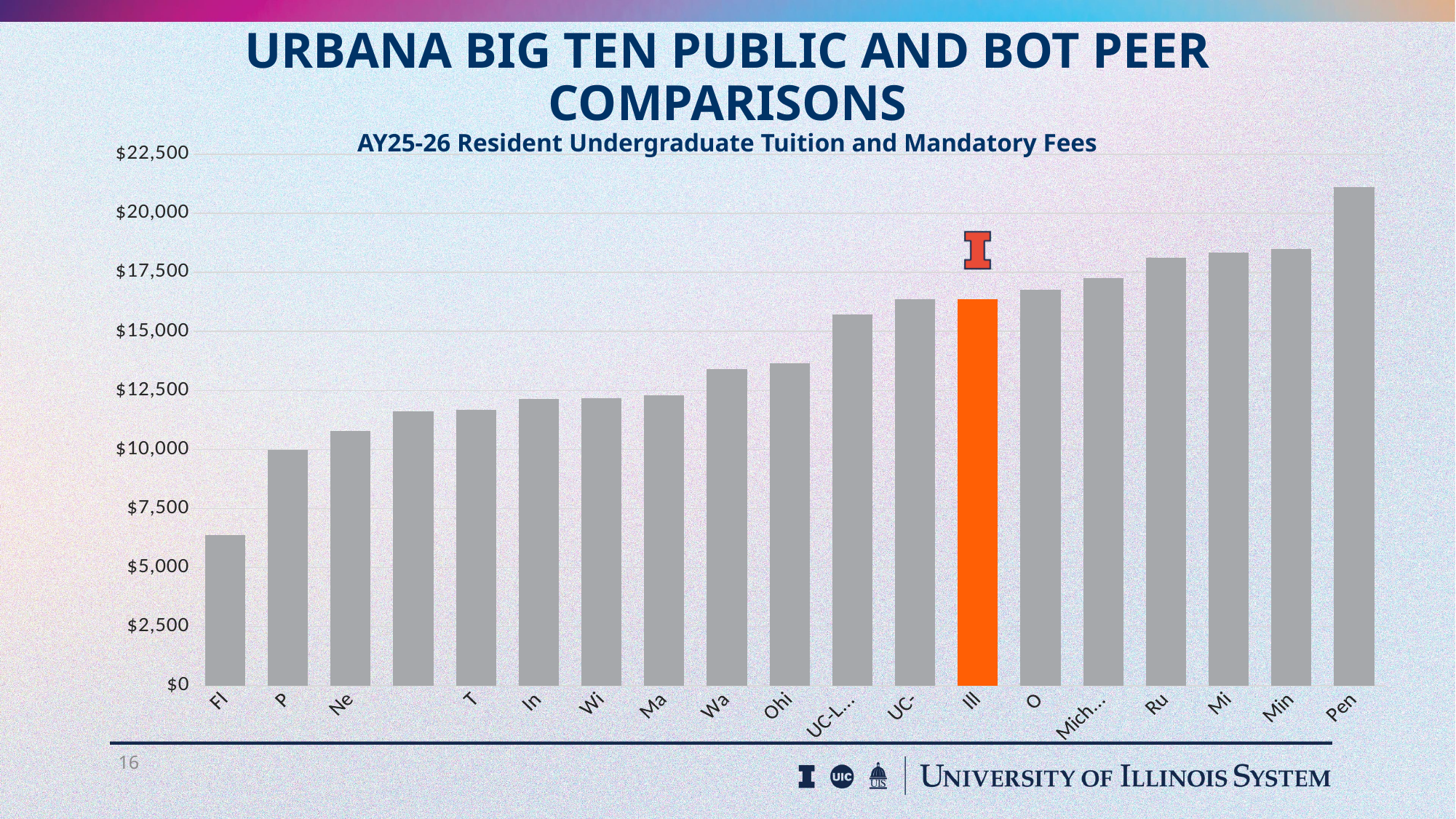
Is the value for Fl greater or less than $7,500? less Which is larger, the value for Ill or the value for Fl? Ill Do the values generally rise or fall from left to right along the x axis? Rise Which category has the highest value? Pen Is the value for Pen greater or less than $20,000? greater Which category's bar is highlighted in orange? Ill Is the value for Ohi greater or less than $12,500? greater What kind of chart is shown on the slide? Bar chart Which category has the lowest value? Fl